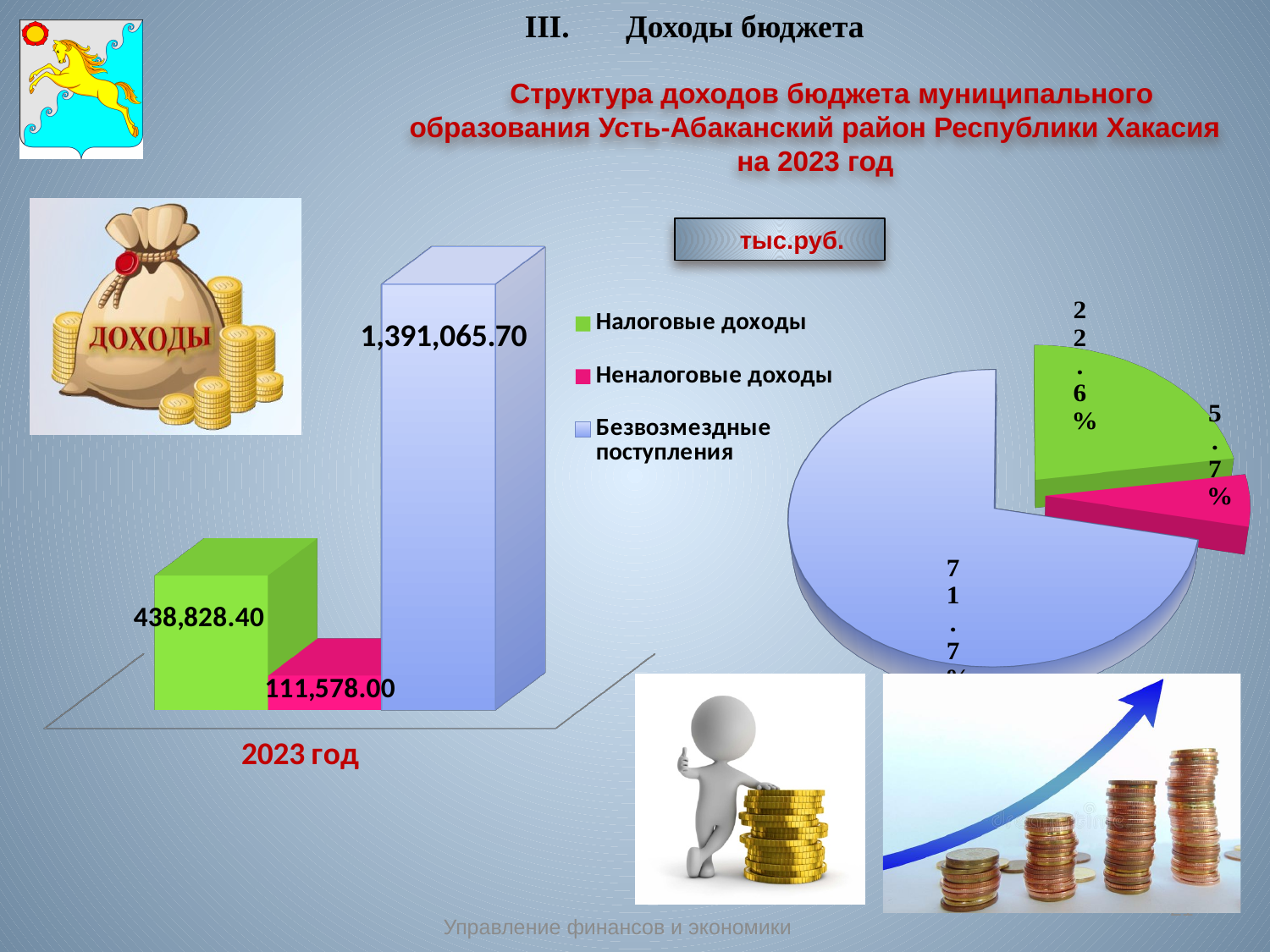
In the pie chart, what share is shown for the green slice (Налоговые доходы)? 22.6% How many series does the legend of the bar chart list? 3 In the bar chart, what is the value for Безвозмездные поступления? 1,391,065.70 What kind of chart is shown on the left side of the slide? Bar chart In the bar chart, which series has the lowest value? Неналоговые доходы In the bar chart, which is larger: Налоговые доходы or Неналоговые доходы? Налоговые доходы In the bar chart, what is the value for Налоговые доходы? 438,828.40 In the bar chart, which series has the highest value? Безвозмездные поступления In the bar chart, what is the difference between Налоговые доходы and Неналоговые доходы? 327,250.40 In the bar chart, what is the value for Неналоговые доходы? 111,578.00 In the pie chart, what share is shown for the pink slice (Неналоговые доходы)? 5.7% What kind of chart is shown on the right side of the slide? Pie chart